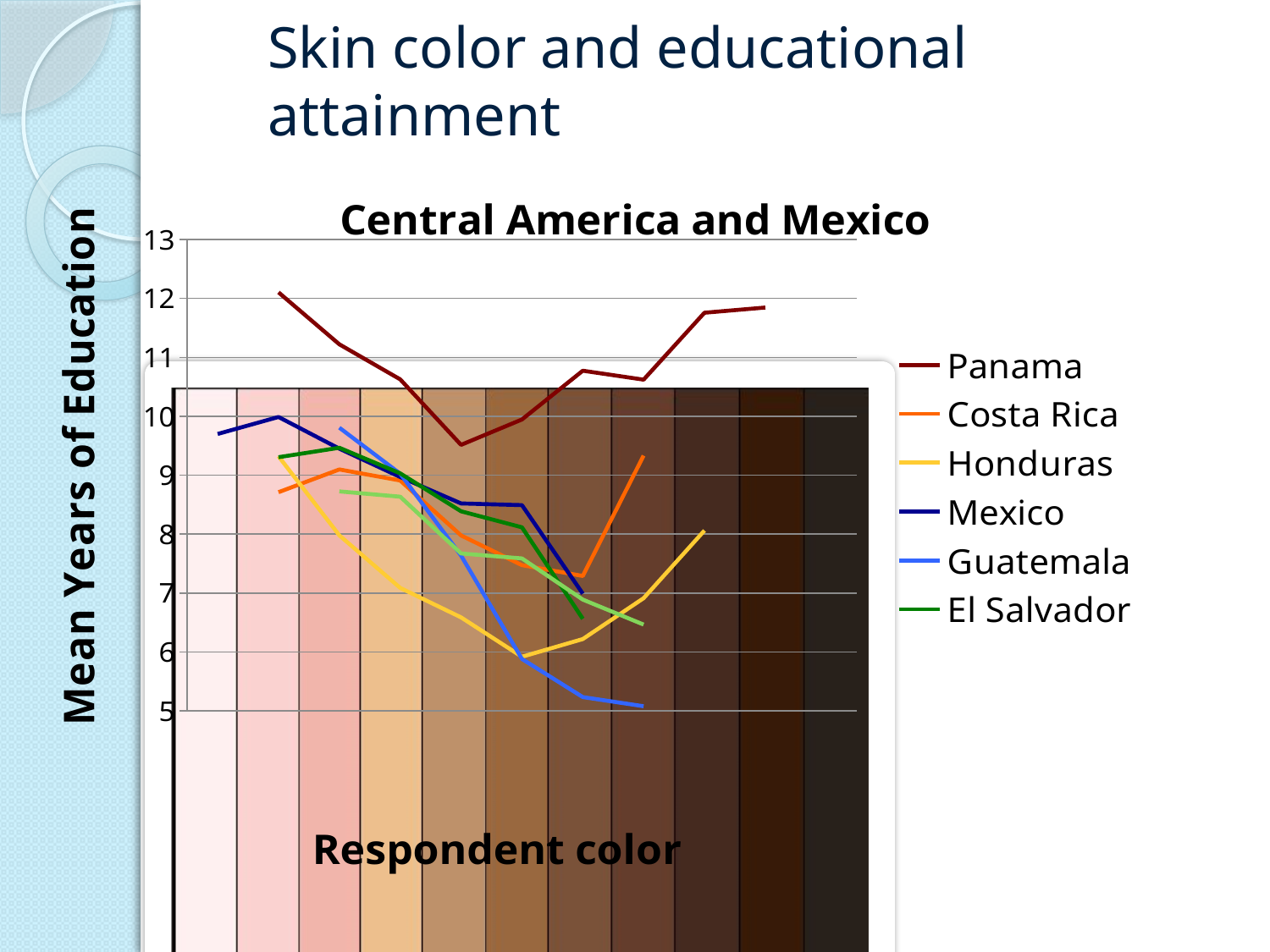
How many series does the legend list? 6 Is the last (rightmost) value for Honduras greater or less than 7? greater Which country's line is the highest across the chart? Panama Is the first (leftmost) value for Panama greater or less than 11? greater Is the lowest value for Guatemala greater or less than 6? less What is the label of the vertical axis? Mean Years of Education Which country's line reaches the lowest value on the chart? Guatemala Which line is higher, Panama or Guatemala? Panama What kind of chart is shown on the slide? line chart Does the Guatemala line rise or fall from left to right along the x axis? fall What is the title of the chart? Central America and Mexico